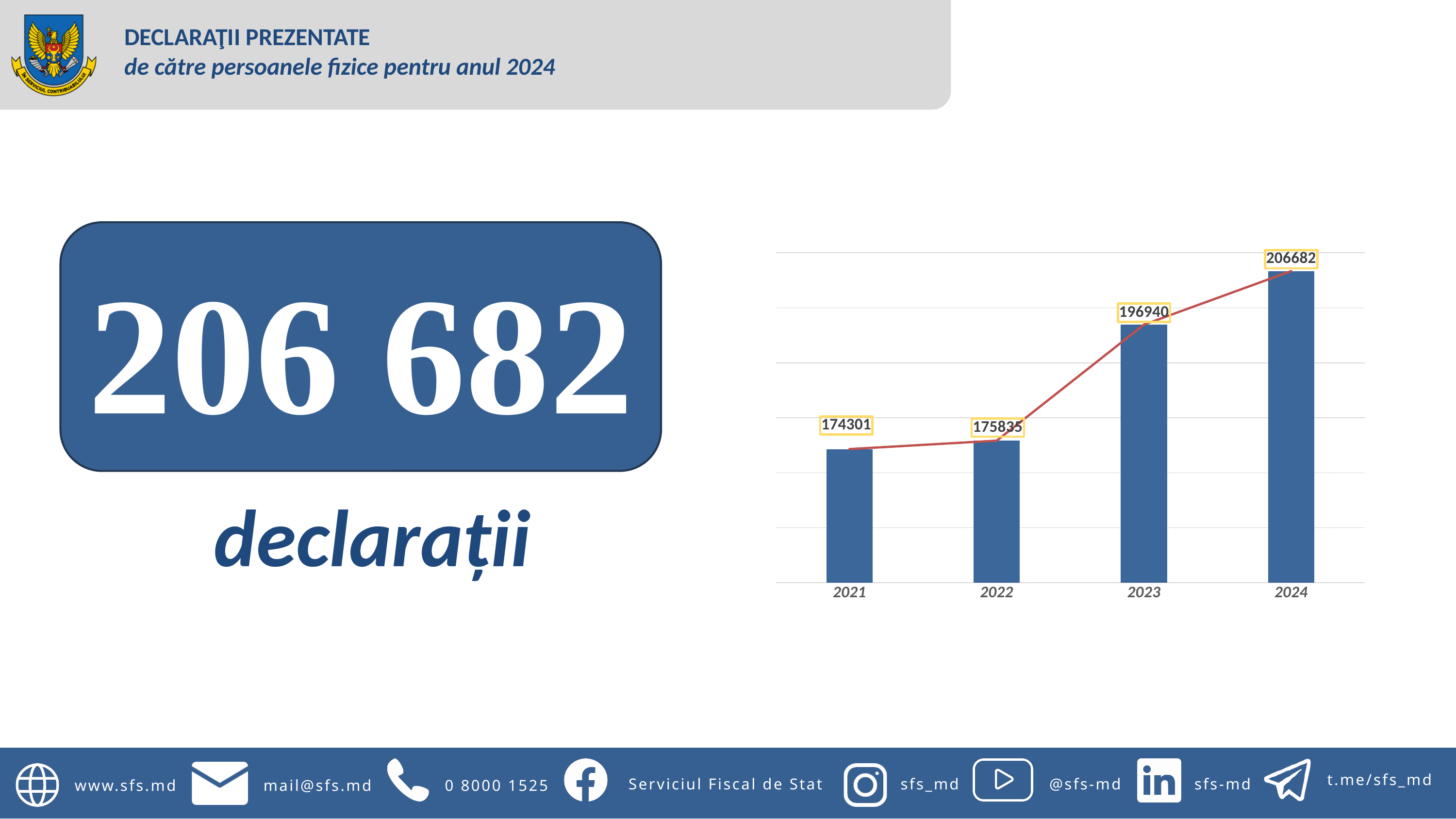
Which year has the highest value? 2024 Do the values rise or fall from 2021 to 2024? rise What is the difference between the values for 2024 and 2023? 9742 Which is larger, the value for 2023 or the value for 2022? 2023 Which year has the lowest value? 2021 What is the difference between the values for 2022 and 2021? 1534 What is the value shown for 2023? 196940 What is the value shown for 2022? 175835 How many years are shown on the x axis of the chart? 4 What is the value shown for 2024? 206682 What kind of chart is shown on the slide? combination bar and line chart What is the value shown for 2021? 174301